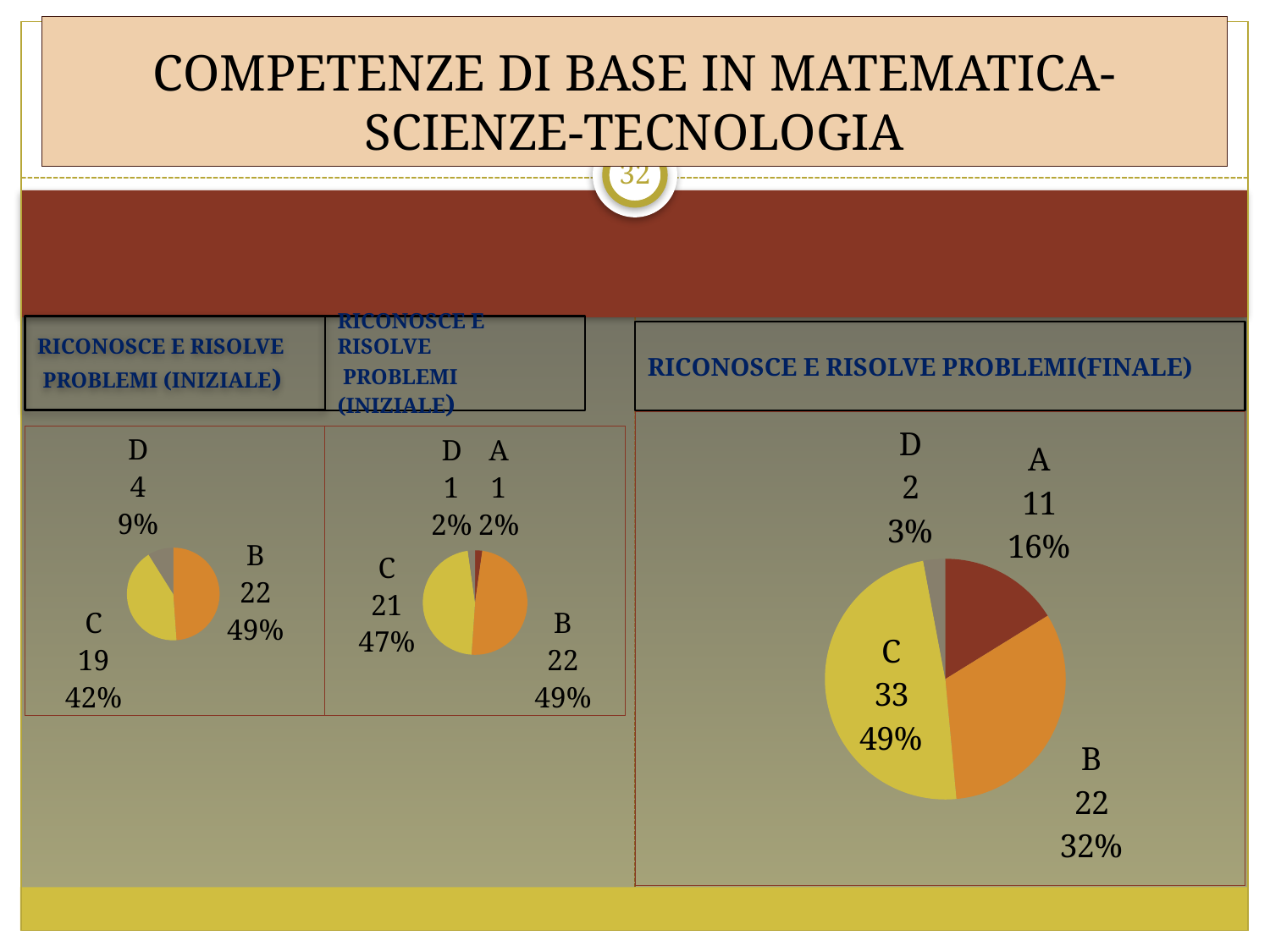
In the left-most pie chart (INIZIALE), what is the value for category C? 19 In the left-most pie chart (INIZIALE), which category has the largest value? B In the middle pie chart (INIZIALE), which is larger, the value for B or the value for D? B In the middle pie chart (INIZIALE), what is the value for category C? 21 In the right-hand pie chart (FINALE), what share of the pie does category A represent? 16% In the middle pie chart (INIZIALE), how many categories are shown? 4 In the right-hand pie chart (FINALE), which category has the largest value? C In the left-most pie chart (INIZIALE), what share of the pie does category D represent? 9% What type of chart is used on this slide? Pie chart In the right-hand pie chart (RICONOSCE E RISOLVE PROBLEMI (FINALE)), what is the value for category C? 33 In the right-hand pie chart (FINALE), which category has the smallest value? D In the right-hand pie chart (FINALE), what is the difference between the values for C and B? 11